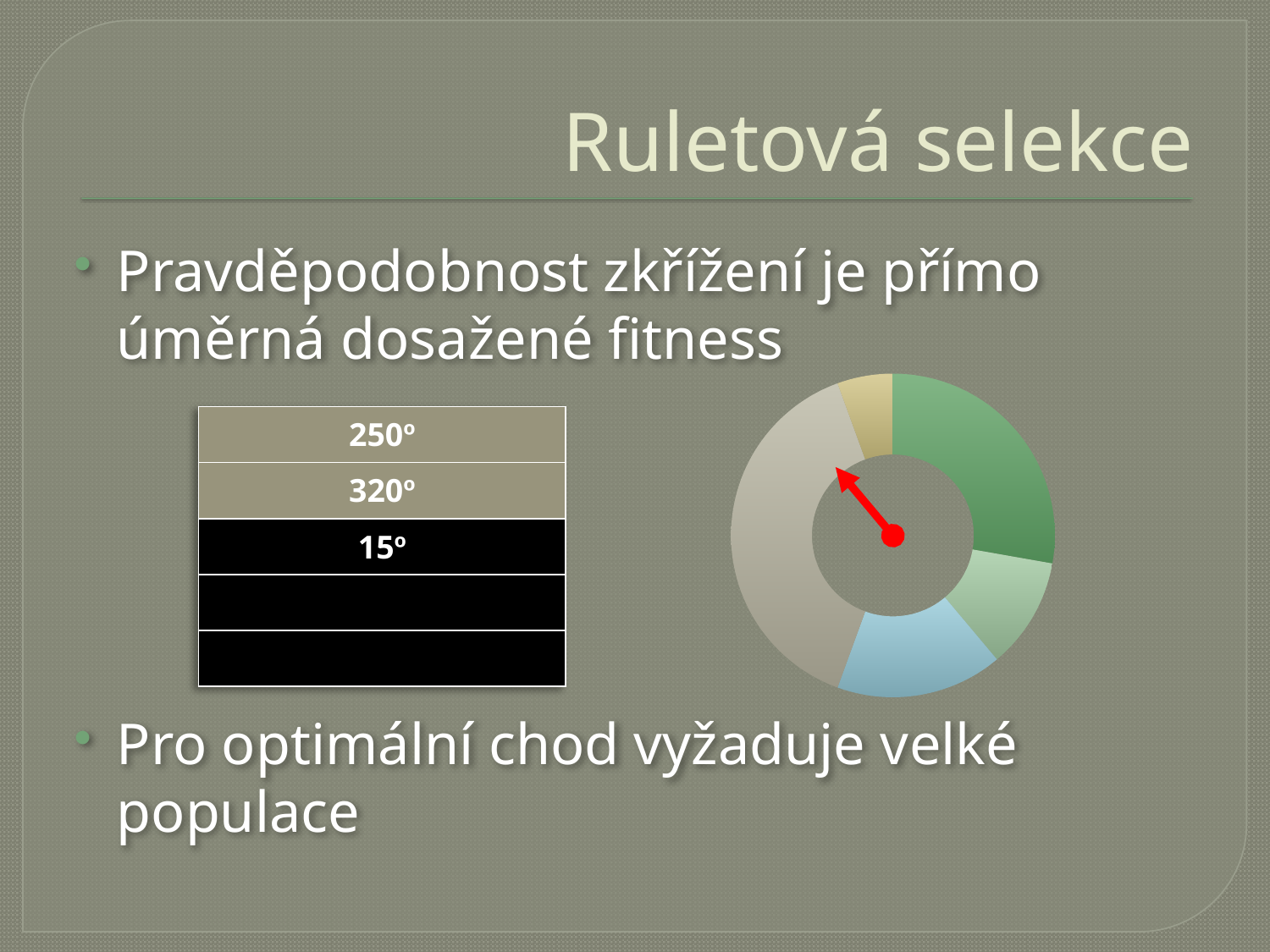
What colour is the arrow drawn in the centre of the doughnut chart? red How many slices does the doughnut chart on the slide contain? 5 Does the doughnut chart on the slide display a legend? No What kind of chart is shown on the right side of the slide? doughnut chart Which is larger in the doughnut chart, the dark green slice or the light blue slice? the dark green slice Which is larger in the doughnut chart, the light blue slice or the yellow slice? the light blue slice Which slice of the doughnut chart is the largest? the grey/beige slice Which is larger in the doughnut chart, the grey/beige slice or the dark green slice? the grey/beige slice